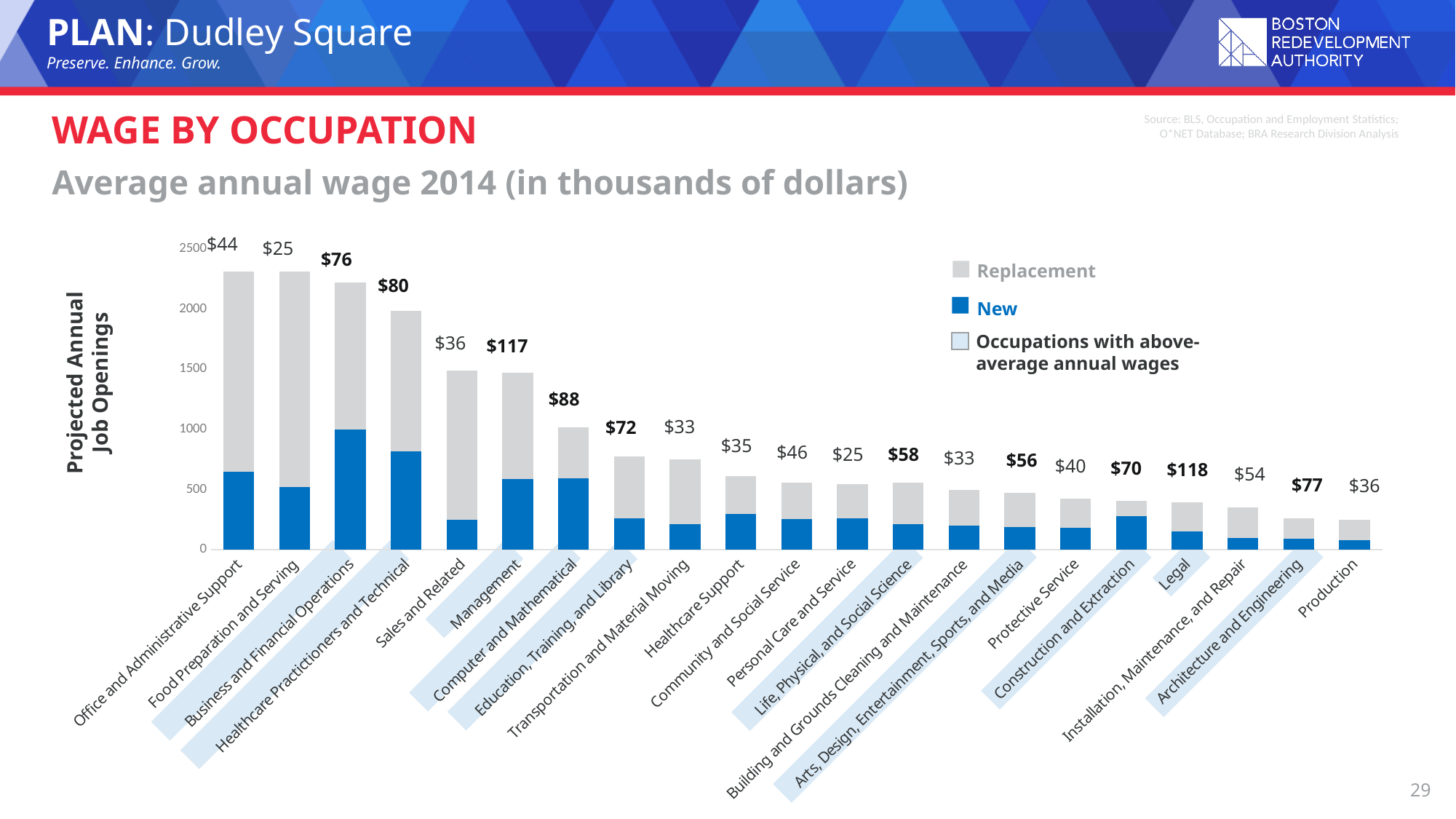
How many occupation categories are shown on the x axis? 21 Is the total projected annual job openings bar for Office and Administrative Support greater or less than 2000? greater What is the average annual wage shown for Management? $117 What is the average annual wage shown for Healthcare Support? $35 What is the difference between the wage labels for Healthcare Practitioners and Technical and Healthcare Support? $45 Which occupation has the highest average annual wage label on the chart? Legal What is the average annual wage shown for Construction and Extraction? $70 What is the difference between the wage labels for Legal and Management? $1 What kind of chart is shown on the slide? Stacked bar chart Is the total projected annual job openings bar for Production greater or less than 500? less Which has a higher wage label, Computer and Mathematical or Architecture and Engineering? Computer and Mathematical What is the lowest average annual wage value labeled on the chart? $25